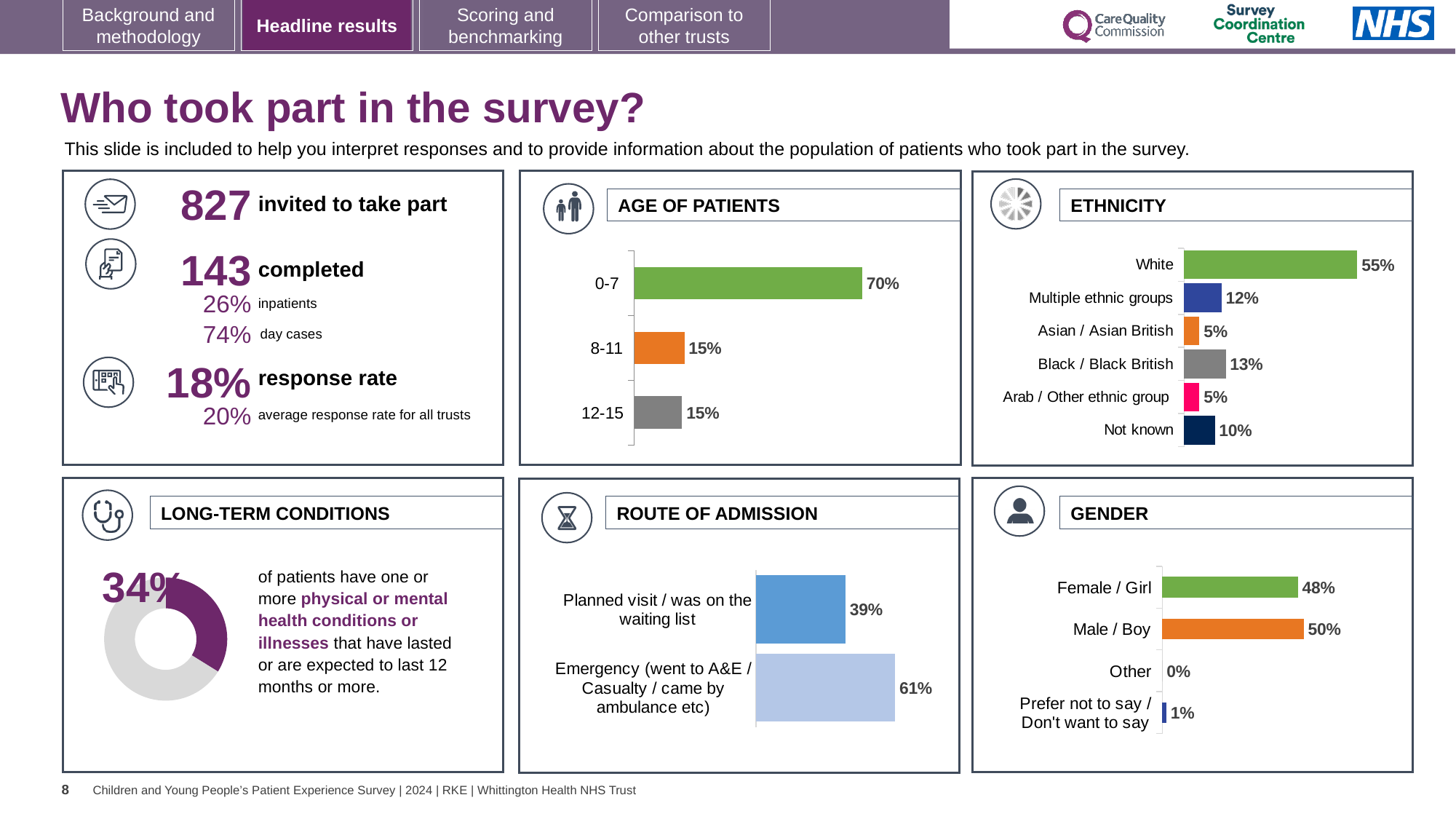
What kind of chart is the GENDER chart? Bar chart In the GENDER chart, which category has the lowest value? Other In the AGE OF PATIENTS chart, which age group has the highest value? 0-7 In the ETHNICITY chart, what is the difference between White and Not known? 45% In the GENDER chart, what is the value for Male / Boy? 50% In the AGE OF PATIENTS chart, what is the value for the 0-7 age group? 70% In the ETHNICITY chart, which category has the highest value? White In the AGE OF PATIENTS chart, how many age groups are shown? 3 In the ETHNICITY chart, what is the value for Black / Black British? 13% In the ROUTE OF ADMISSION chart, which is larger: Planned visit / was on the waiting list or Emergency? Emergency In the ROUTE OF ADMISSION chart, what is the value for Emergency (went to A&E / Casualty / came by ambulance etc)? 61% In the ETHNICITY chart, how many categories are shown? 6